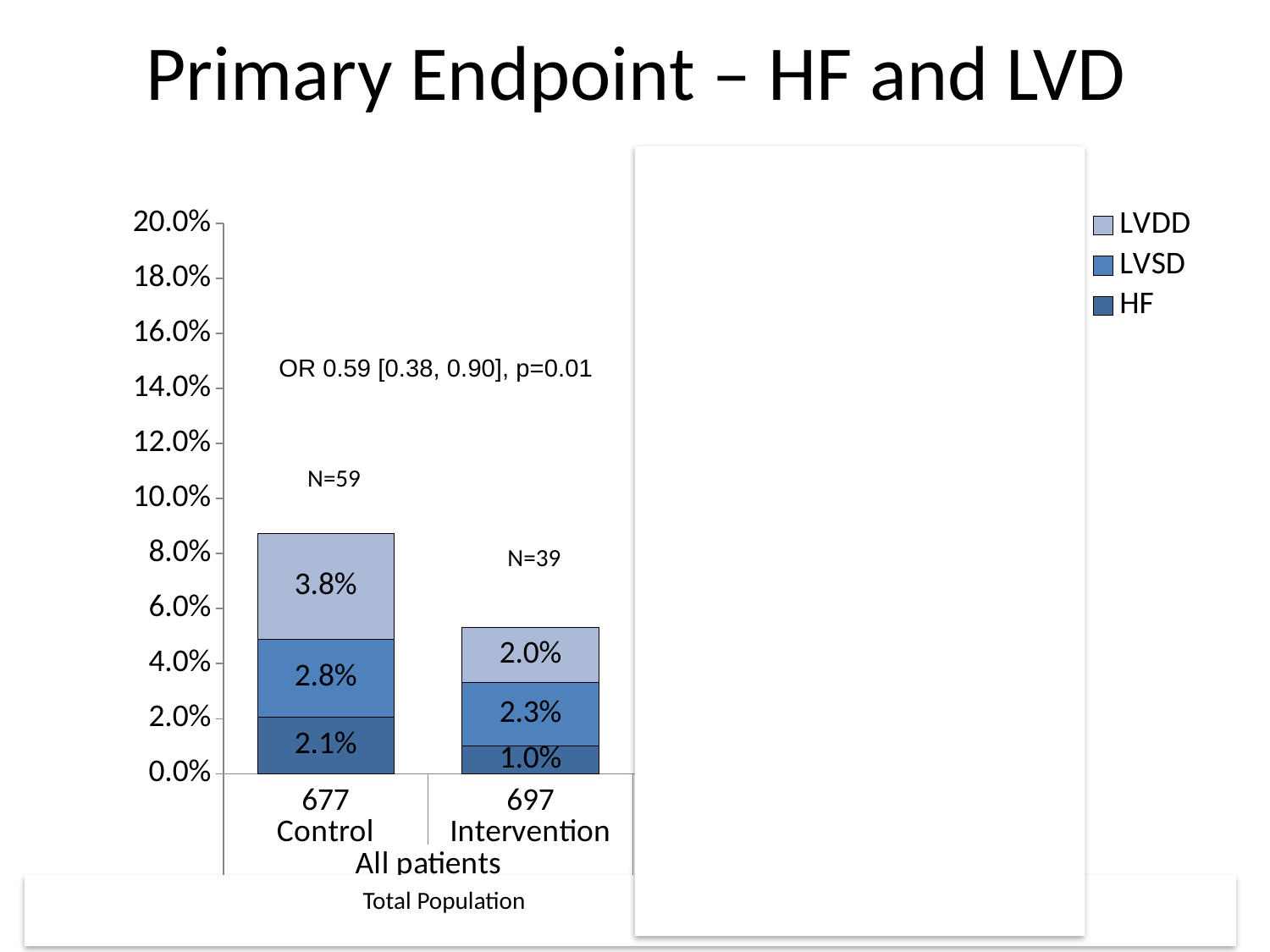
What odds ratio is annotated on the chart? OR 0.59 [0.38, 0.90], p=0.01 What kind of chart is shown on the slide? stacked bar chart What is the HF value for the Control group? 2.1% What is the HF value for the Intervention group? 1.0% How many series does the legend list? 3 How many bars are plotted in the chart? 2 What is the LVDD value for the Control group? 3.8% What is the LVSD value for the Intervention group? 2.3% What is the total of the stacked bar for the Intervention group? 5.3% Which group has the larger HF value, Control or Intervention? Control What is the total of the stacked bar for the Control group? 8.7% What is the difference between the LVDD values for Control and Intervention? 1.8%